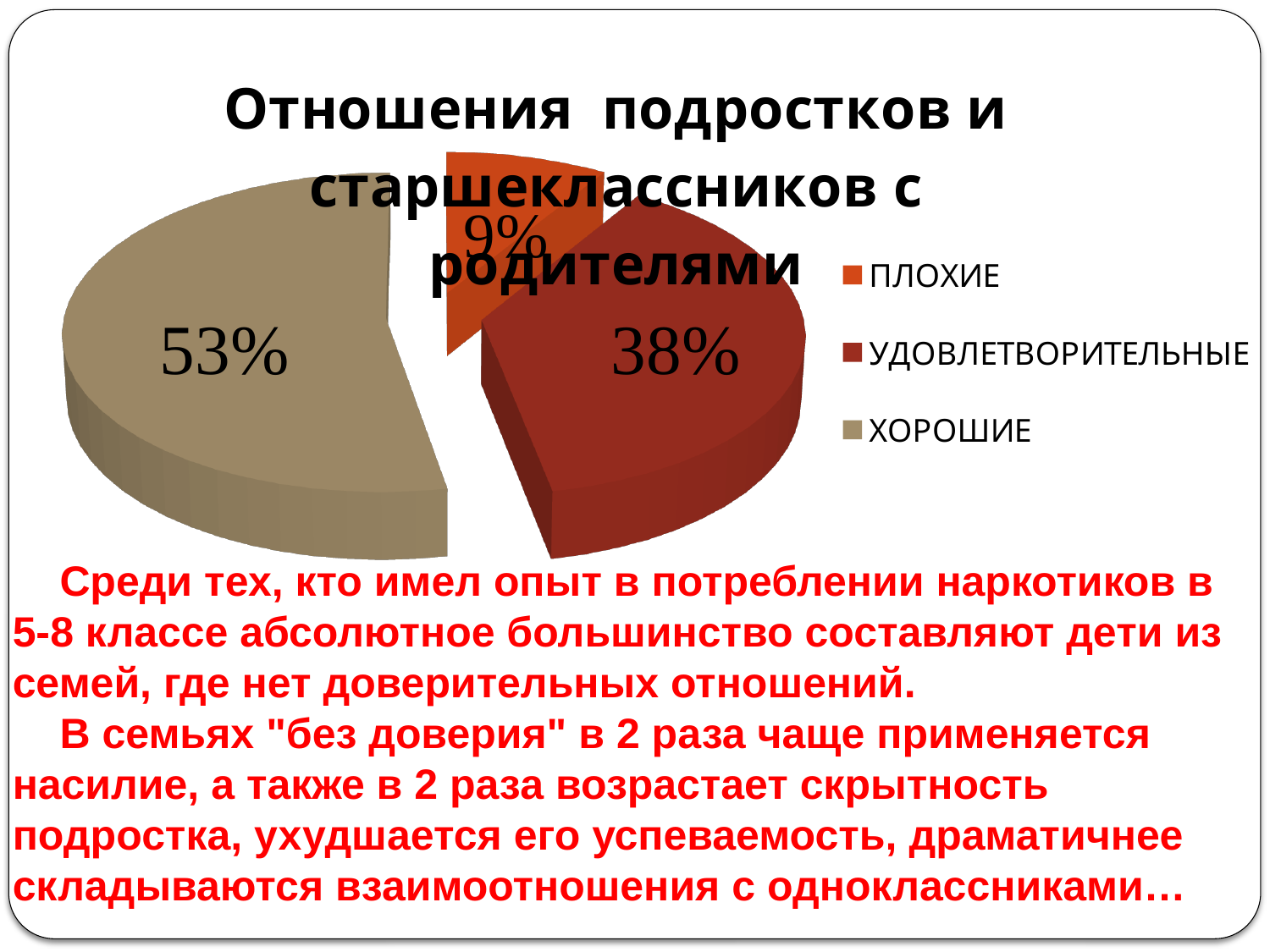
What share of the pie is labelled ХОРОШИЕ? 53% What is the title of the chart? Отношения подростков и старшеклассников с родителями How many categories does the pie chart have? 3 What is the difference in percentage points between the УДОВЛЕТВОРИТЕЛЬНЫЕ and ПЛОХИЕ slices? 29% Which category has the largest slice of the pie? ХОРОШИЕ What share of the pie is labelled УДОВЛЕТВОРИТЕЛЬНЫЕ? 38% What is the difference in percentage points between the ХОРОШИЕ and УДОВЛЕТВОРИТЕЛЬНЫЕ slices? 15% What kind of chart is shown on the slide? pie chart What colour is the slice for ПЛОХИЕ? orange Which category has the smallest slice of the pie? ПЛОХИЕ What share of the pie is labelled ПЛОХИЕ? 9% Which slice is larger, УДОВЛЕТВОРИТЕЛЬНЫЕ or ПЛОХИЕ? УДОВЛЕТВОРИТЕЛЬНЫЕ